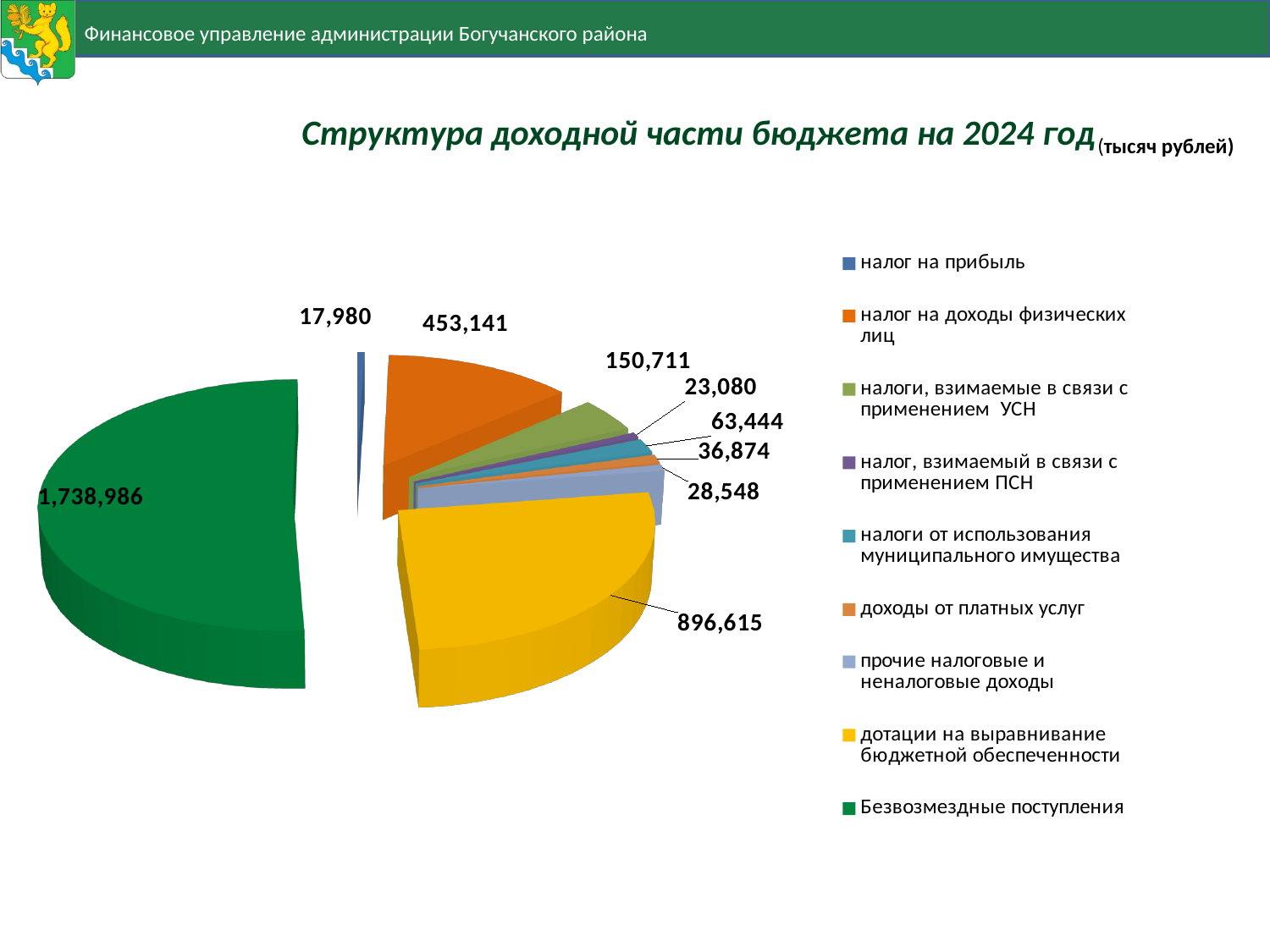
What is the difference between «Безвозмездные поступления» and «дотации на выравнивание бюджетной обеспеченности»? 842,371 What is the value for «дотации на выравнивание бюджетной обеспеченности»? 896,615 How many categories does the legend list? 9 What is the title of the chart? Структура доходной части бюджета на 2024 год (тысяч рублей) Which category has the smallest slice of the pie? налог на прибыль Which is larger: «налог на доходы физических лиц» or «налоги, взимаемые в связи с применением УСН»? налог на доходы физических лиц What is the value for «налоги, взимаемые в связи с применением УСН»? 150,711 What is the value for «налог на доходы физических лиц»? 453,141 What is the value for «Безвозмездные поступления»? 1,738,986 What kind of chart is shown on the slide? pie chart What is the value for «налог на прибыль»? 17,980 Which category has the largest slice of the pie? Безвозмездные поступления